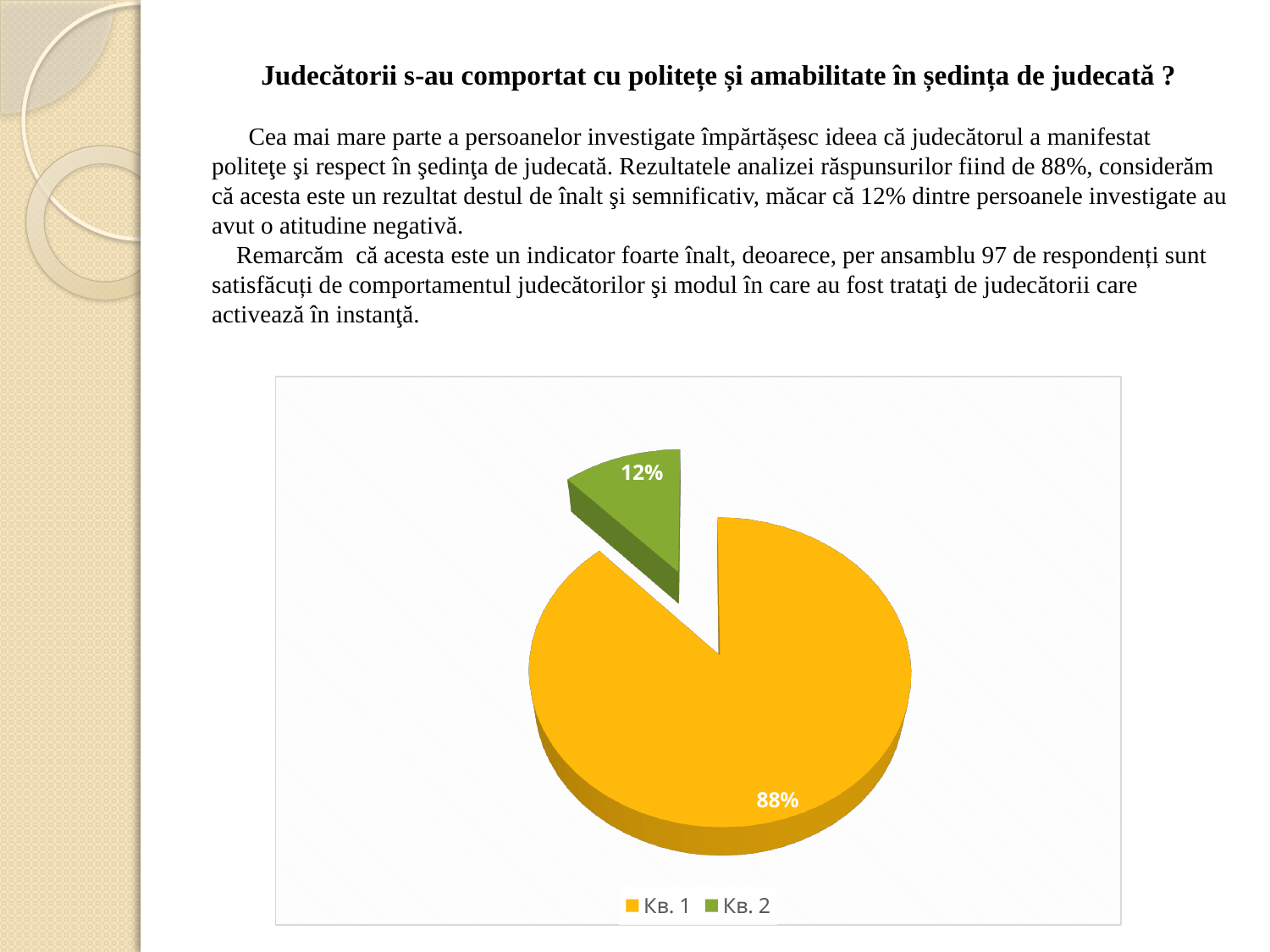
Which slice of the pie is the smallest? Кв. 2 Which slice is larger, Кв. 1 or Кв. 2? Кв. 1 What colour is the slice labelled 88%? yellow How many slices does the pie chart have? 2 What colour is the slice labelled 12%? green Which slice of the pie is the largest? Кв. 1 What kind of chart is shown on the slide? pie chart What is the difference in percentage points between the Кв. 1 slice and the Кв. 2 slice? 76 What share of the pie does the slice labelled Кв. 1 represent? 88% What share of the pie does the slice labelled Кв. 2 represent? 12% How many entries does the legend list? 2